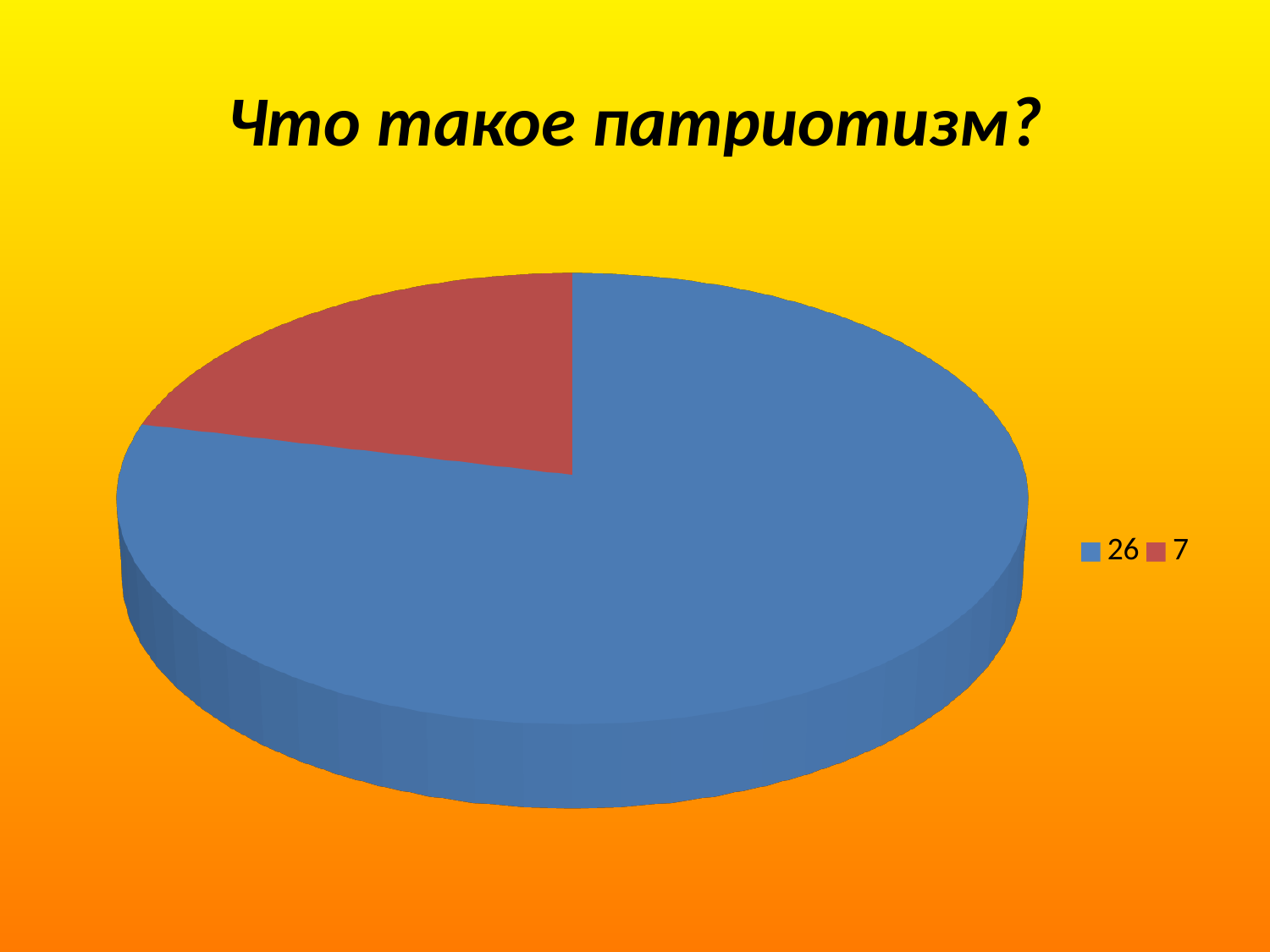
How many entries does the legend of the pie chart list? 2 What kind of chart is shown on the slide? pie chart Which slice is larger in the pie chart, the one labelled 26 or the one labelled 7? 26 What colour is the slice labelled 26 in the pie chart? blue Which legend entry corresponds to the largest slice of the pie chart? 26 What colour is the slice labelled 7 in the pie chart? red Which legend entry corresponds to the smallest slice of the pie chart? 7 Is the blue slice of the pie chart larger or smaller than half of the pie? larger How many slices does the pie chart have? 2